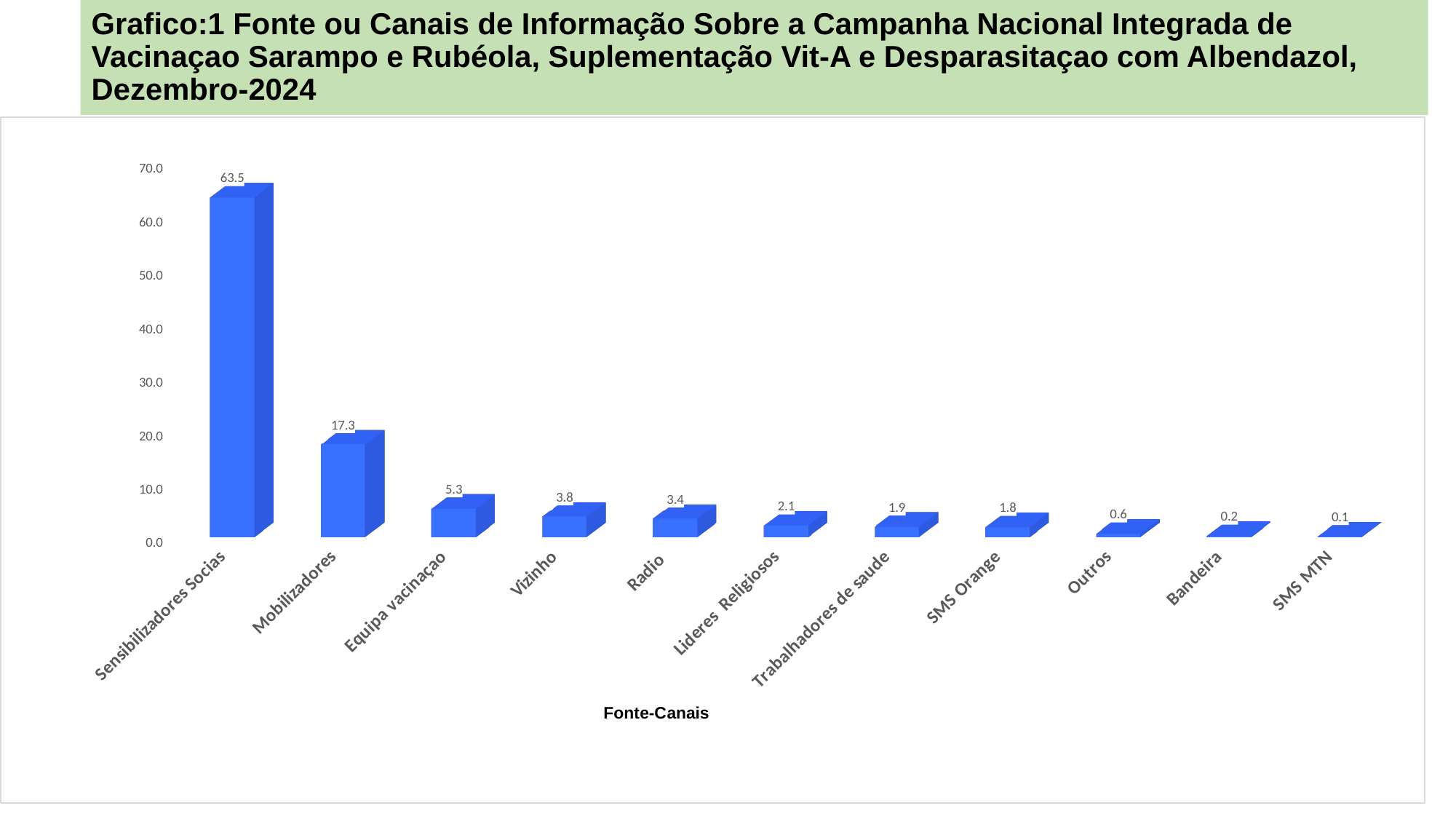
What is the value for Sensibilizadores Socias? 63.5 Which category has the highest value? Sensibilizadores Socias What is the value for Mobilizadores? 17.3 What is the difference between the values for Sensibilizadores Socias and Mobilizadores? 46.2 What kind of chart is this? bar chart How many categories are shown on the x axis? 11 What is the x-axis title of the chart? Fonte-Canais What is the value for Radio? 3.4 Which is larger, the value for Lideres Religiosos or the value for Outros? Lideres Religiosos What is the difference between the values for Equipa vacinaçao and Vizinho? 1.5 What is the value for SMS Orange? 1.8 Which category has the lowest value? SMS MTN